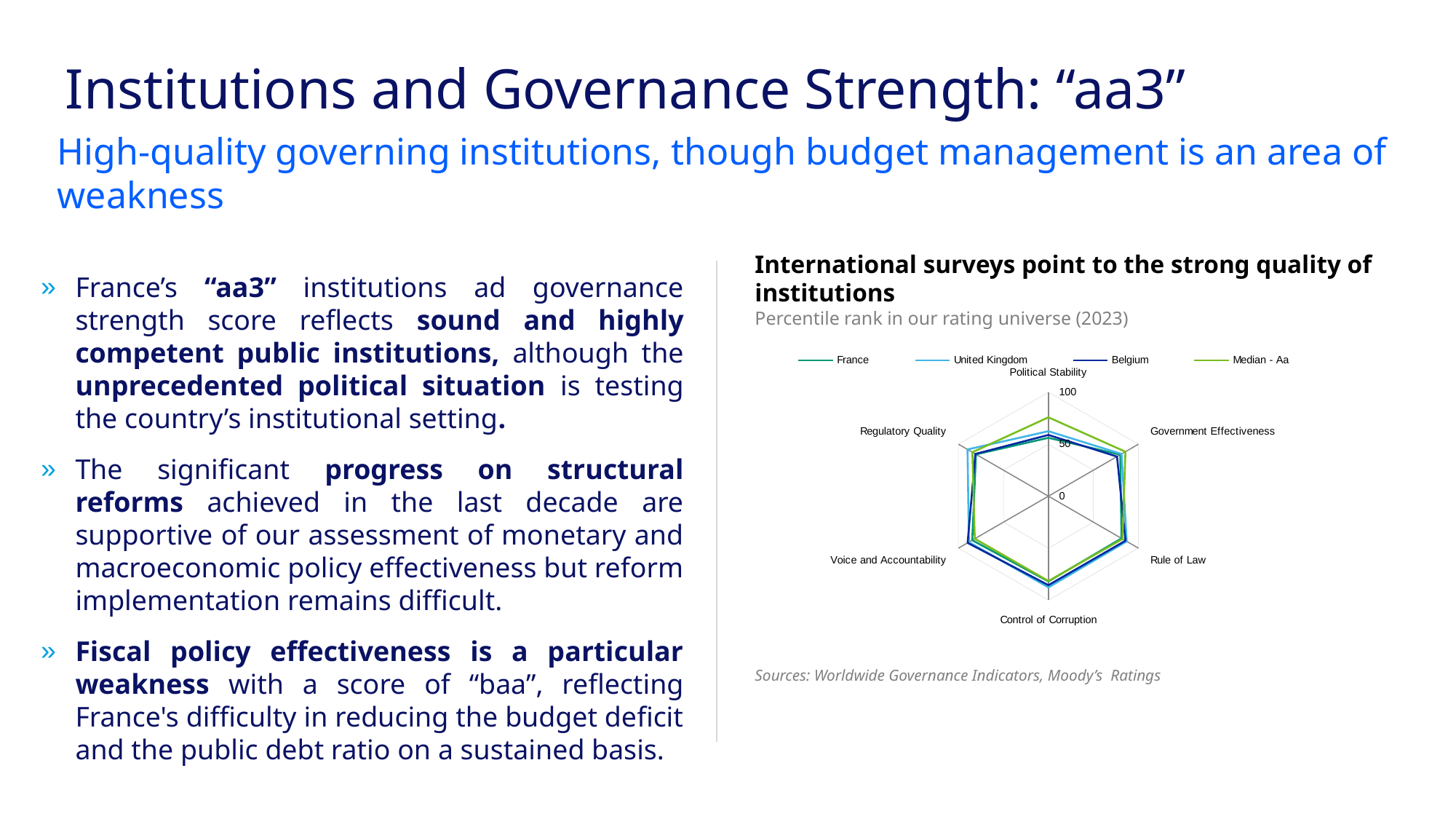
On which indicator axis do all the series score lowest? Political Stability Is the value for Voice and Accountability for the United Kingdom greater or less than 50? greater How many series does the chart's legend list? 4 Is the value for Control of Corruption for France greater or less than 50? greater Which series are listed in the chart's legend? France, United Kingdom, Belgium, Median - Aa Is the value for Political Stability for Median - Aa greater or less than 100? less What is the title of the chart? International surveys point to the strong quality of institutions How many indicator axes does the radar chart have? 6 What kind of chart is shown on the slide? Radar chart